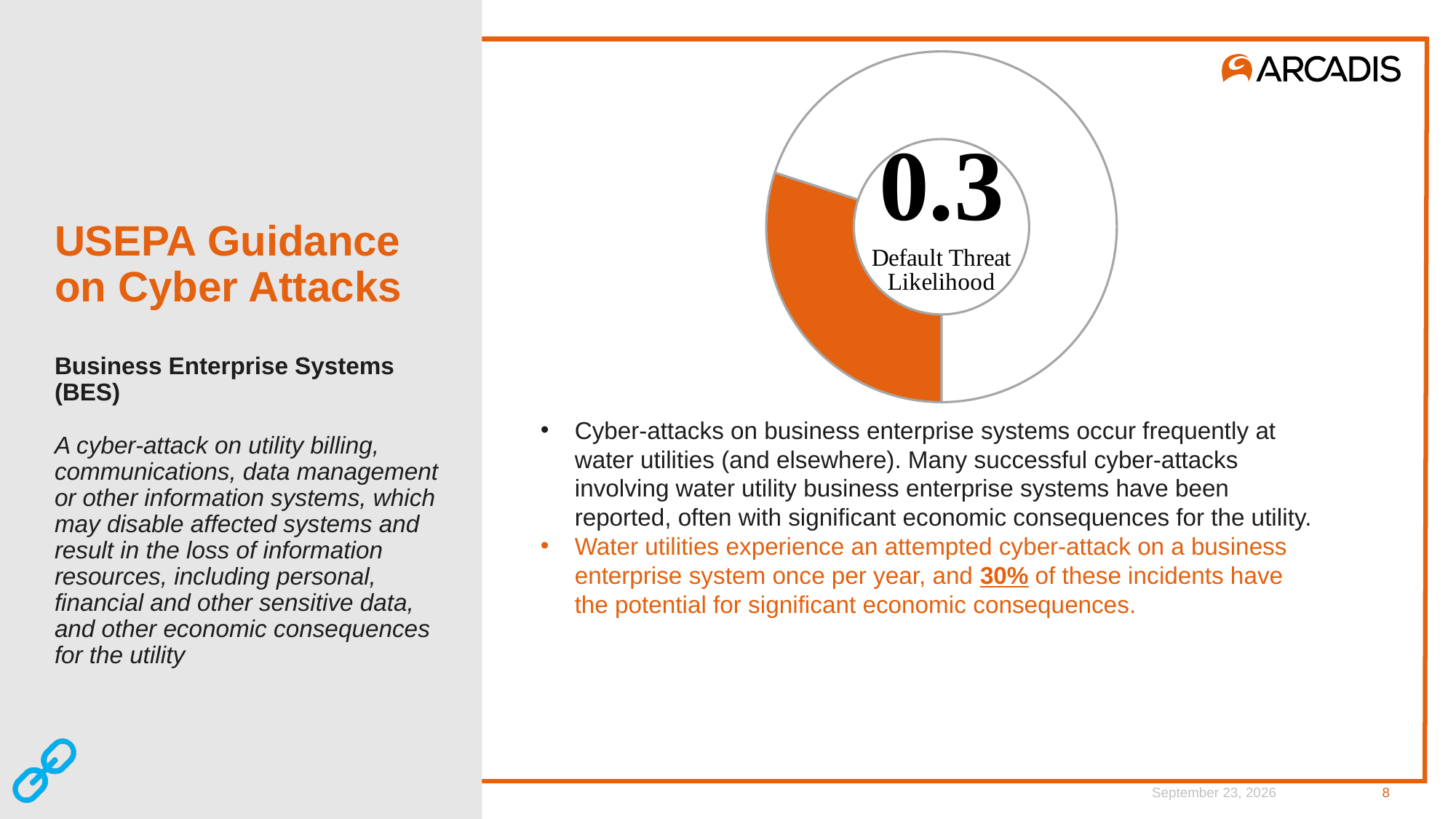
What colour is the smaller slice of the doughnut chart? orange What kind of chart is shown on the slide? doughnut chart Does the doughnut chart show a legend? No Is the orange slice of the doughnut chart greater or less than half of the ring? less Which slice of the doughnut chart is larger, the orange slice or the white slice? the white slice How many slices does the doughnut chart have? 2 What label appears beneath the number in the centre of the doughnut chart? Default Threat Likelihood What value is printed in the centre of the doughnut chart? 0.3